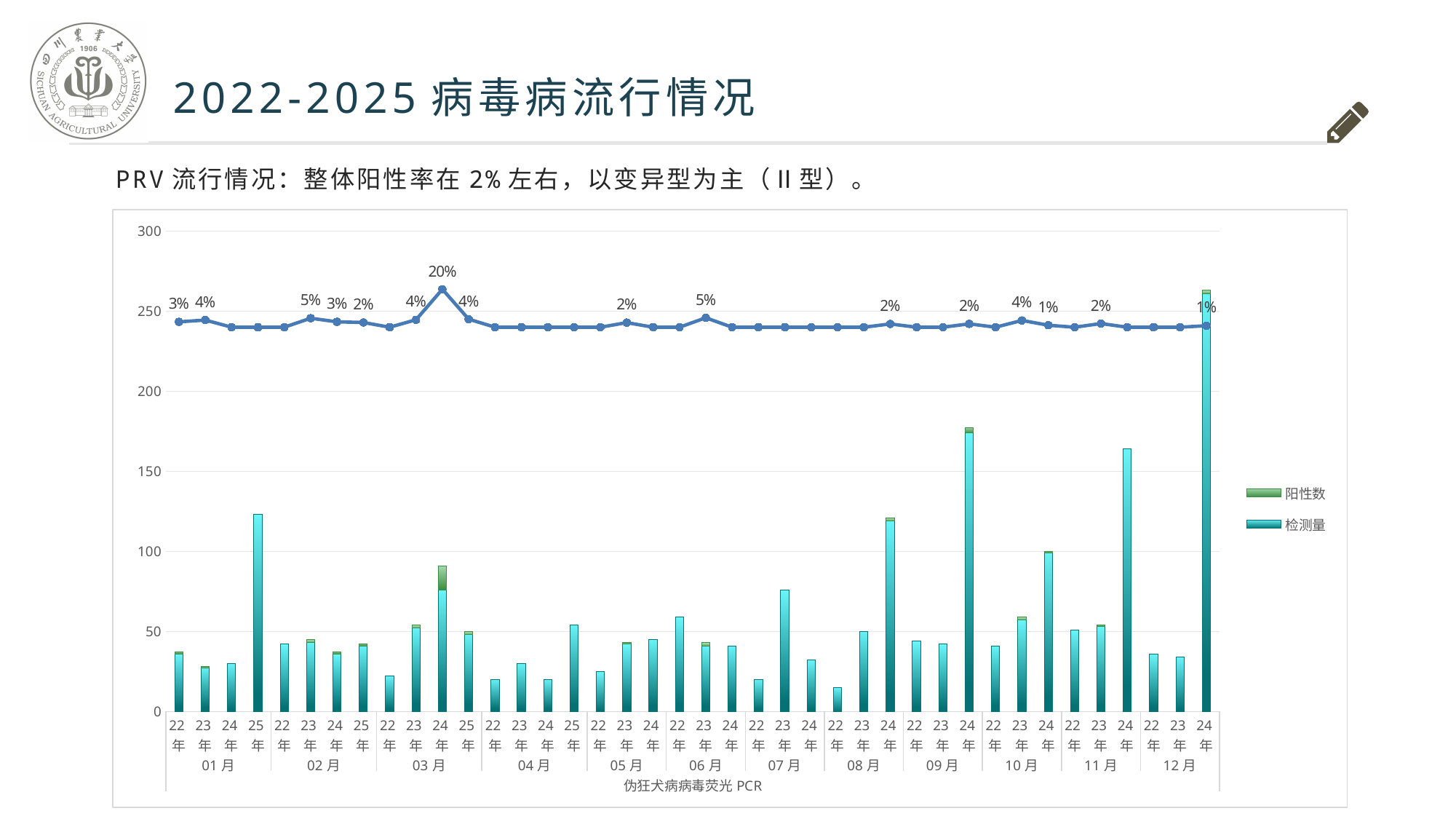
What positive rate is labelled on the line for 10月 24年? 1% Is the 检测量 bar for 12月 24年 greater or less than 250? greater Is the 检测量 bar for 08月 22年 greater or less than 50? less Is the 检测量 bar for 09月 24年 greater or less than 150? greater What positive rate is labelled on the line for 06月 23年? 5% Which month and year has the tallest 检测量 bar? 12月 24年 How many series does the legend list? 2 What kind of chart is shown on the slide? bar chart with a line What positive rate is labelled on the line for 03月 24年? 20% Which month and year has the highest positive rate label on the line? 03月 24年 Which bar is taller, 01月 25年 or 02月 22年? 01月 25年 What is the difference between the positive rate labels for 03月 24年 and 03月 25年? 16%